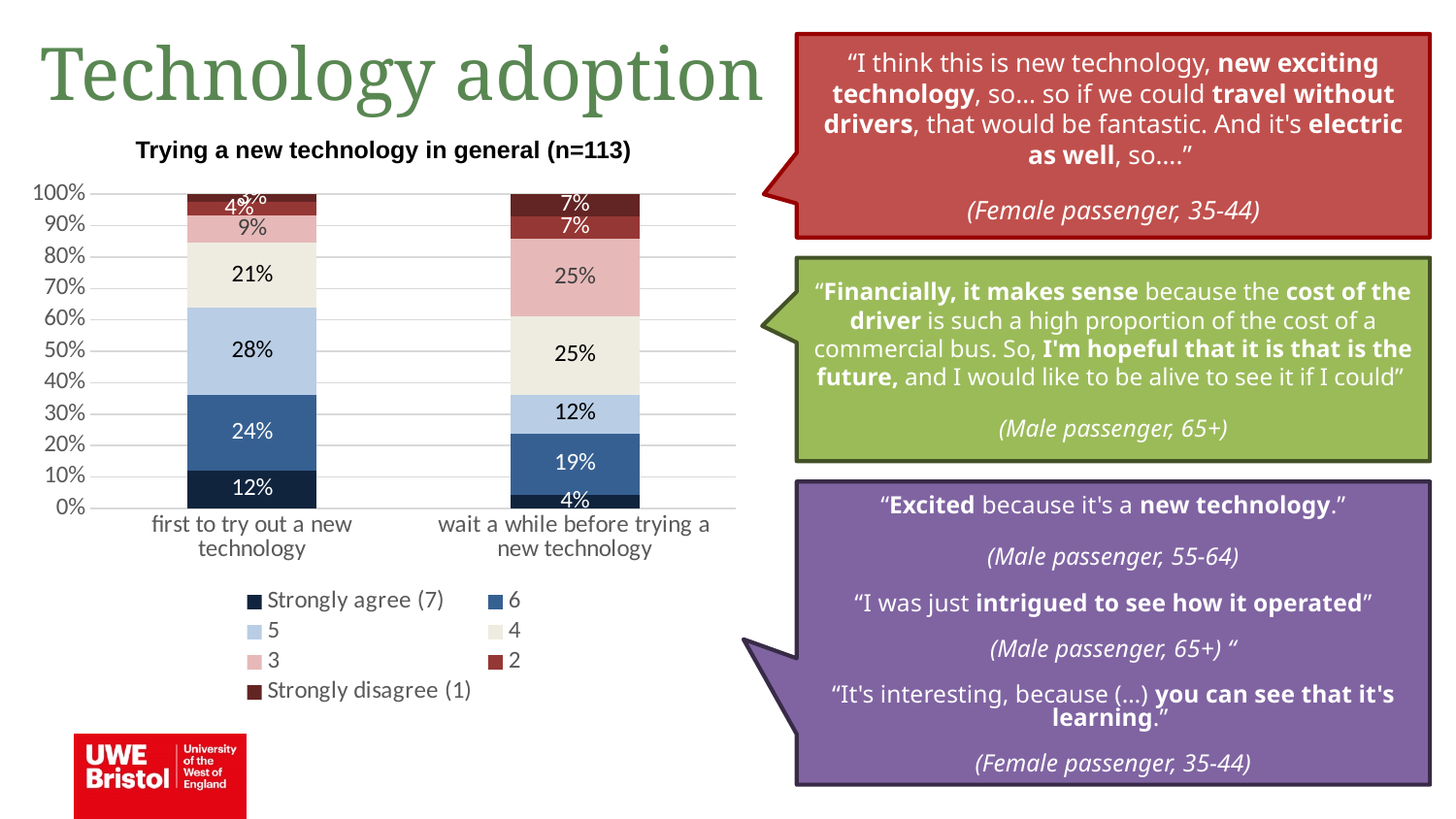
What is the title of the chart? Trying a new technology in general (n=113) What percentage strongly disagree (1) with 'wait a while before trying a new technology'? 7% What is the value of series 6 for 'wait a while before trying a new technology'? 19% What percentage of respondents strongly agree (7) that they are first to try out a new technology? 12% What is the value of series 4 for 'wait a while before trying a new technology'? 25% Which category has the larger 'Strongly agree (7)' value: 'first to try out a new technology' or 'wait a while before trying a new technology'? first to try out a new technology What is the difference between the series 5 values for 'first to try out a new technology' (28%) and 'wait a while before trying a new technology' (12%)? 16% What is the value of series 5 for 'first to try out a new technology'? 28% How many categories are shown on the x axis of the chart? 2 How many series does the chart legend list? 7 What type of chart is shown on the slide? stacked bar chart Which series has the largest segment in the 'first to try out a new technology' bar? 5